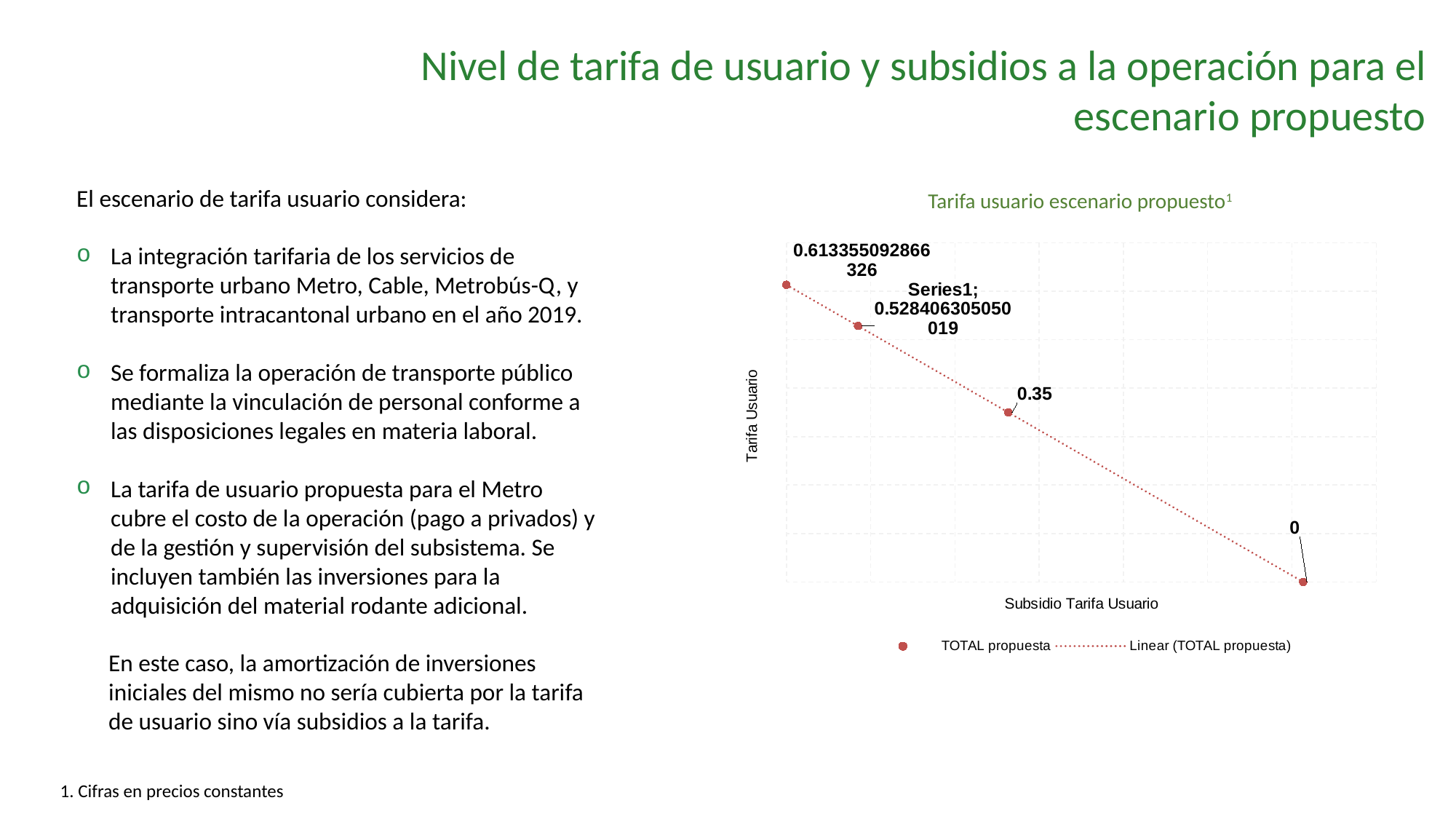
What is the title of the horizontal axis of the chart? Subsidio Tarifa Usuario Do the plotted values rise or fall as you move from left to right along the x axis? fall What kind of chart is shown on the slide? scatter chart How many data points are plotted in the chart? 4 What is the title of the chart? Tarifa usuario escenario propuesto What is the data label on the rightmost (lowest) point in the chart? 0 What is the data label on the third point from the left in the chart? 0.35 How many entries does the chart legend list? 2 What is the lowest labeled value among the plotted points? 0 What is the data label on the leftmost (highest) point in the chart? 0.613355092866326 Which is larger, the value labeled 0.35 or the value labeled 0.528406305050019? 0.528406305050019 What is the highest labeled value among the plotted points? 0.613355092866326